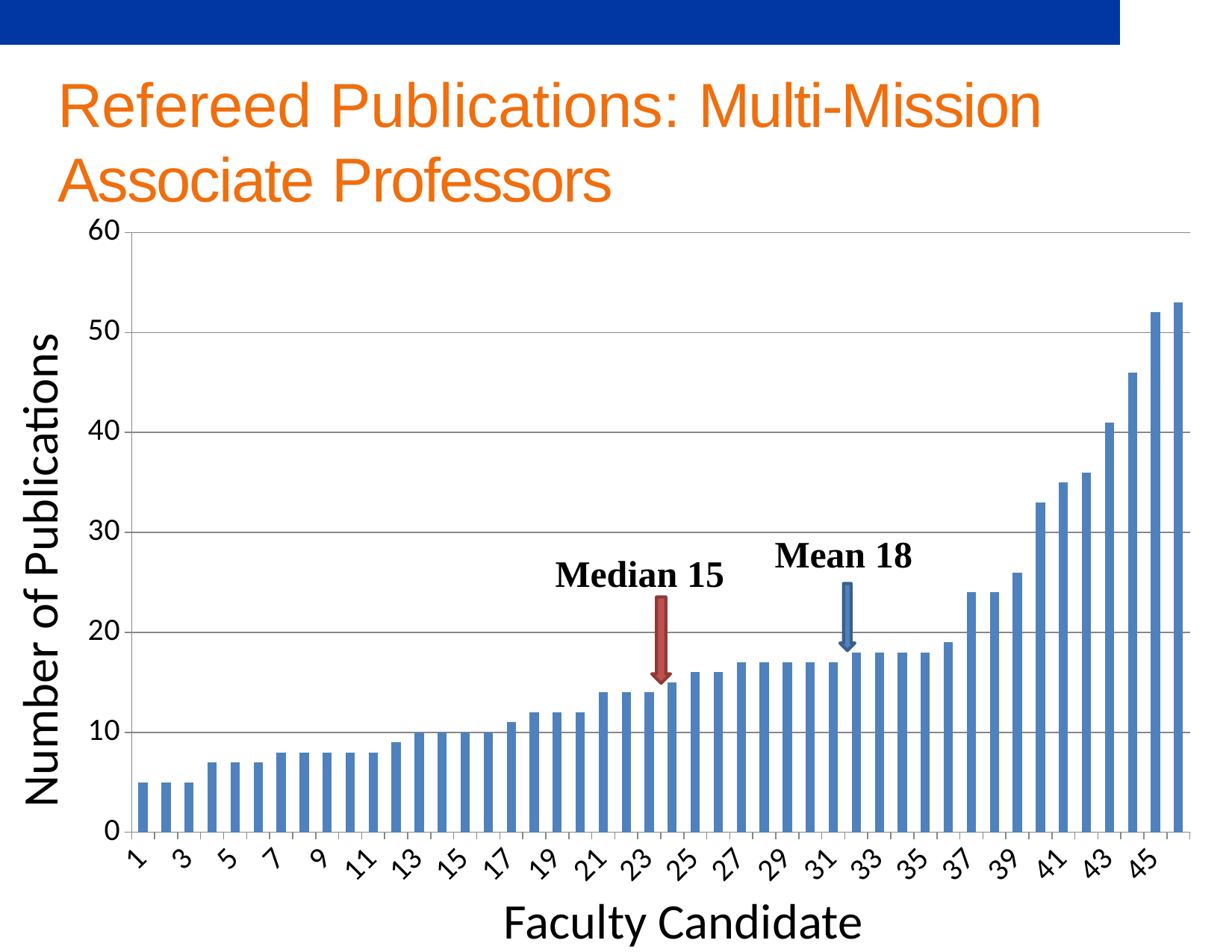
What value does the chart annotation give for the median number of publications? Median 15 Is the number of publications for faculty candidate 45 greater or less than 30? greater Do the number of publications generally rise or fall moving from left to right along the x axis? rise What type of chart is shown on the slide? bar chart Which has more publications, faculty candidate 11 or faculty candidate 41? faculty candidate 41 What is the title of the chart on the slide? Refereed Publications: Multi-Mission Associate Professors Is the number of publications for faculty candidate 25 greater or less than 20? less Is the number of publications for faculty candidate 39 greater or less than 20? greater